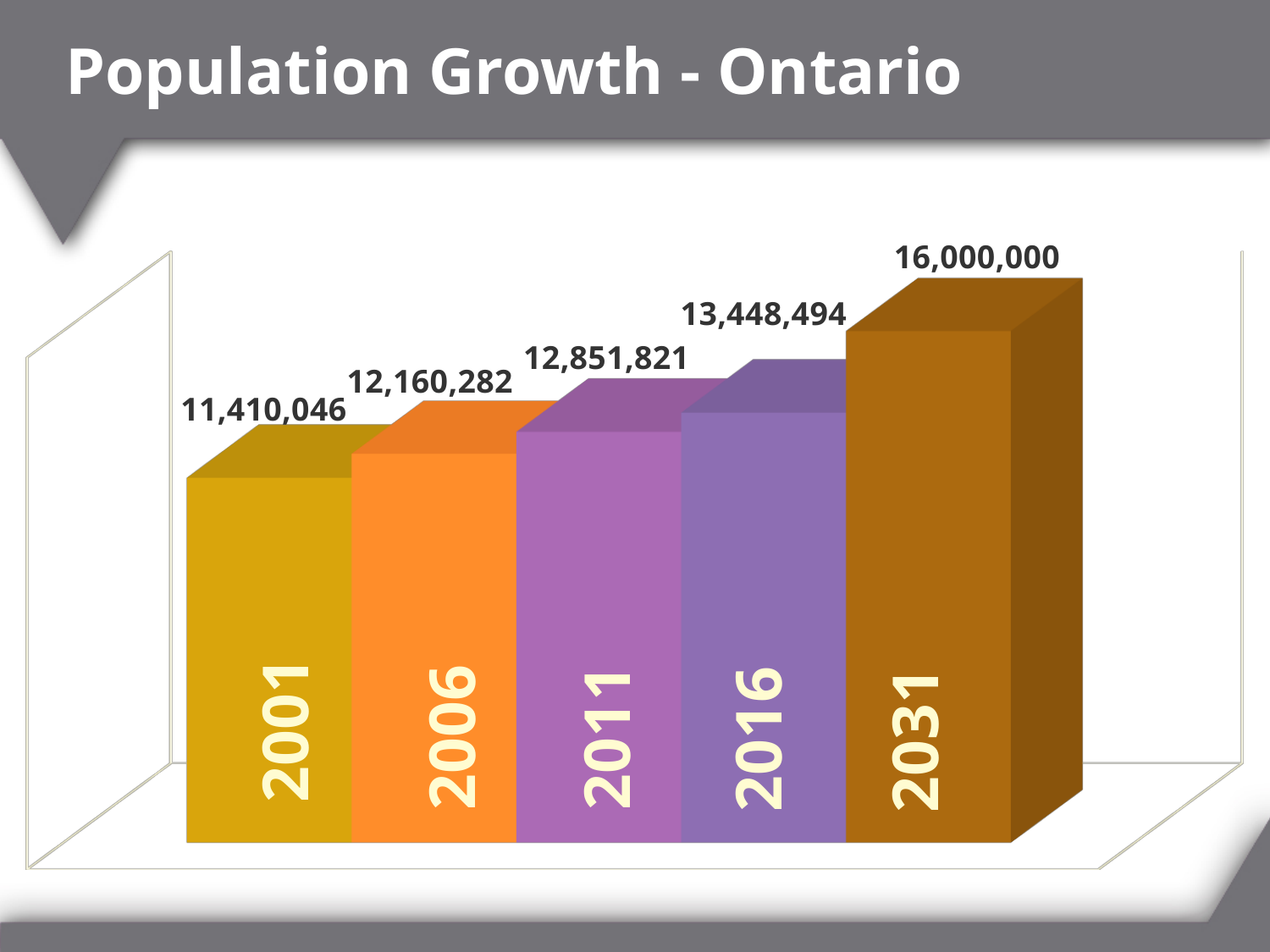
What is the population value shown for 2011? 12,851,821 What is the population value shown for 2016? 13,448,494 What is the difference between the values for 2031 and 2001? 4,589,954 What is the population value shown for 2001? 11,410,046 How many years are shown on the chart? 5 Which year has the lowest population value? 2001 What is the difference between the values for 2016 and 2011? 596,673 Which year has the highest population value? 2031 Which is larger, the value for 2006 or the value for 2011? 2011 Do the values rise or fall from 2001 to 2031? Rise What kind of chart is shown on the slide? Bar chart What is the population value shown for 2031? 16,000,000